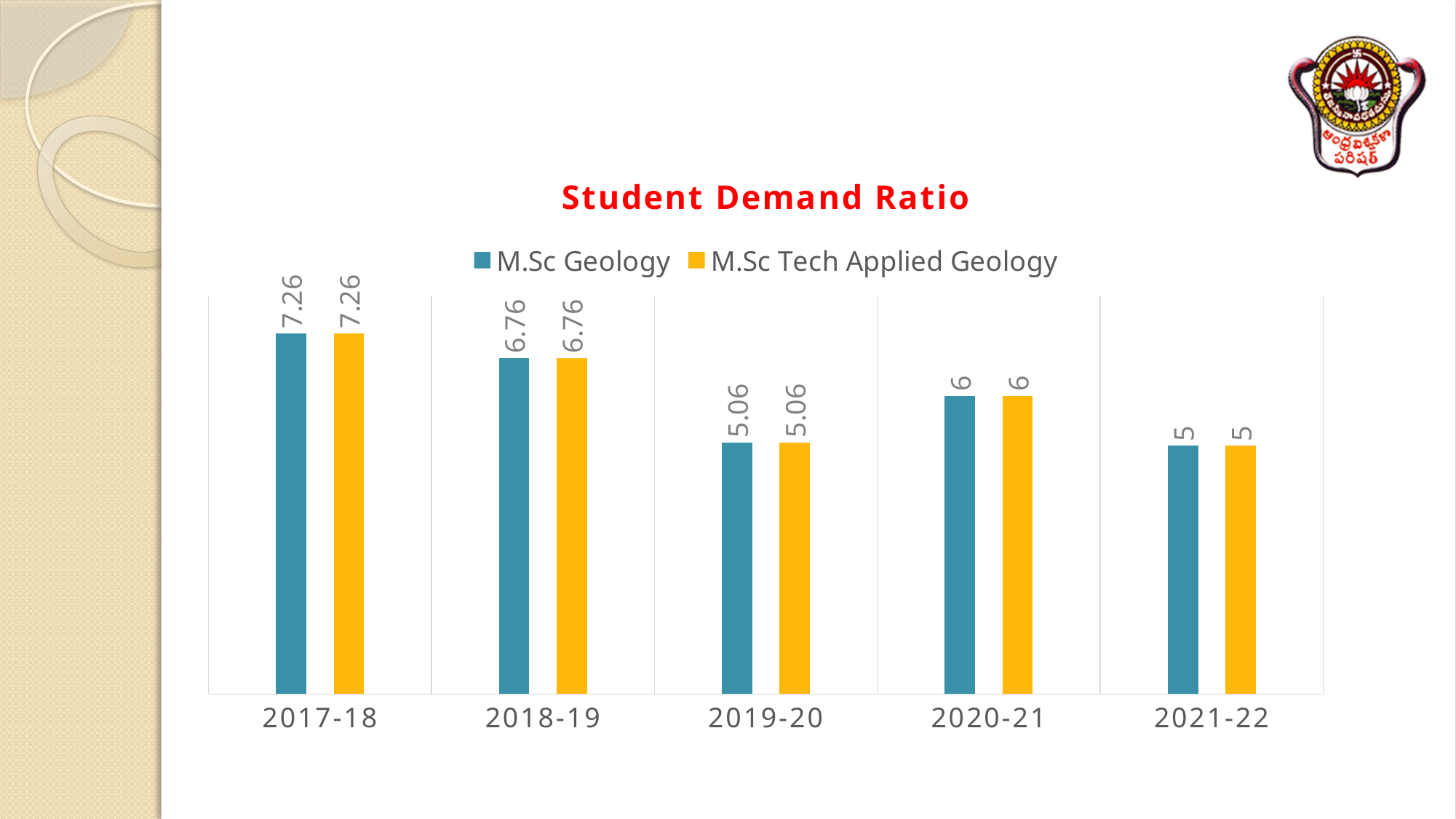
What is the difference between the M.Sc Geology values for 2017-18 and 2018-19? 0.5 Which is larger for M.Sc Geology: the value for 2019-20 or the value for 2020-21? 2020-21 What is the value for M.Sc Tech Applied Geology in 2020-21? 6 How many years are shown on the x axis? 5 How many series does the legend list? 2 What is the value for M.Sc Tech Applied Geology in 2019-20? 5.06 Which year has the highest value for M.Sc Geology? 2017-18 What is the title of the chart? Student Demand Ratio What is the value for M.Sc Geology in 2017-18? 7.26 Which year has the lowest value for M.Sc Tech Applied Geology? 2021-22 What kind of chart is shown on the slide? Bar chart What is the value for M.Sc Geology in 2021-22? 5